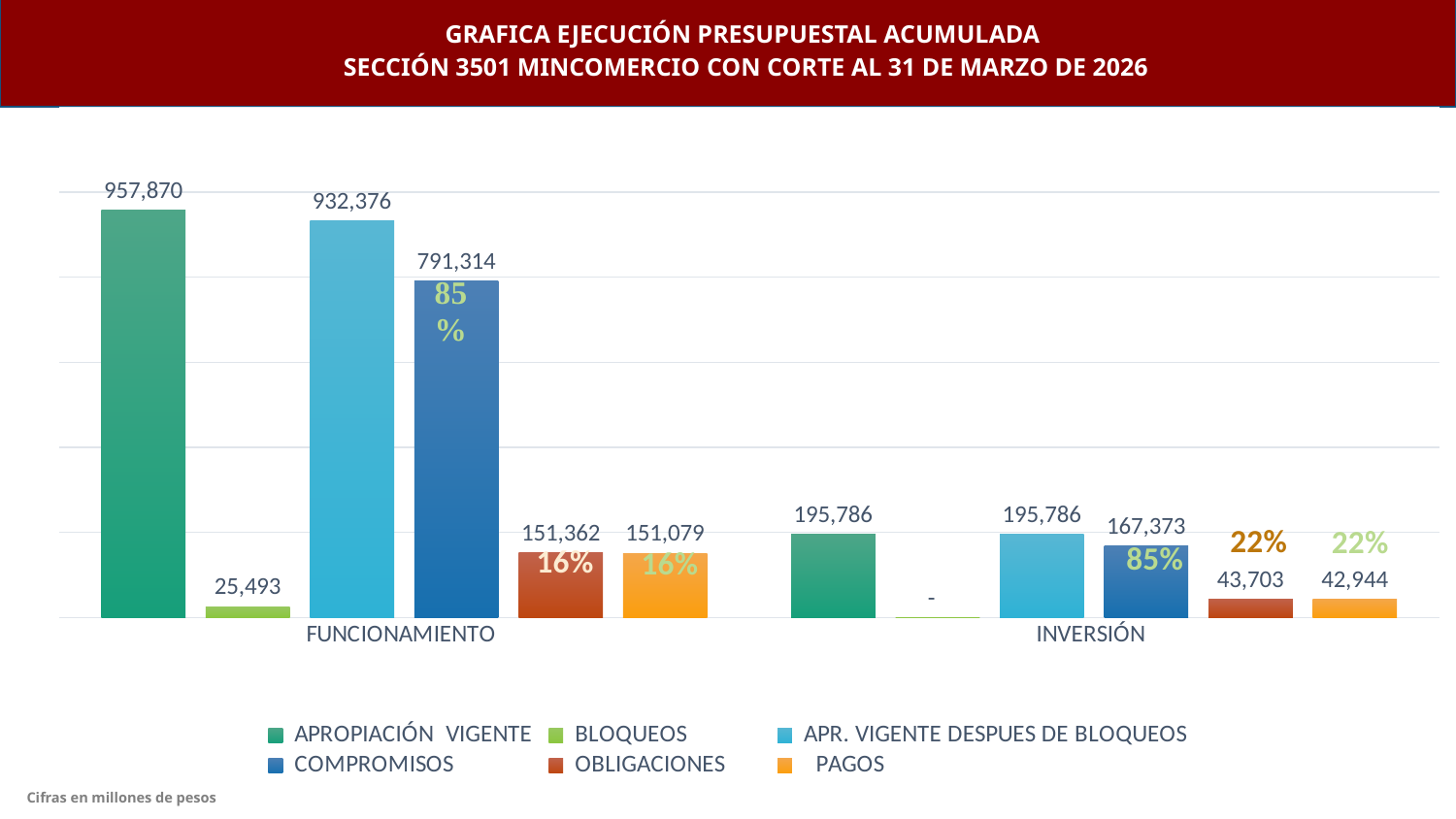
What kind of chart is shown on the slide? Bar chart What is the value of APROPIACIÓN VIGENTE for FUNCIONAMIENTO? 957,870 What is the value of COMPROMISOS for INVERSIÓN? 167,373 Which series has the highest value in the FUNCIONAMIENTO group? APROPIACIÓN VIGENTE Which series has the lowest value in the FUNCIONAMIENTO group? BLOQUEOS What percentage is shown on the PAGOS bar for INVERSIÓN? 22% How many categories are shown on the x axis? 2 What is the difference between OBLIGACIONES and PAGOS for INVERSIÓN? 759 What is the value of BLOQUEOS for FUNCIONAMIENTO? 25,493 What is the difference between APROPIACIÓN VIGENTE and APR. VIGENTE DESPUES DE BLOQUEOS for FUNCIONAMIENTO? 25,494 How many series does the legend list? 6 Which is larger: COMPROMISOS for FUNCIONAMIENTO or COMPROMISOS for INVERSIÓN? COMPROMISOS for FUNCIONAMIENTO